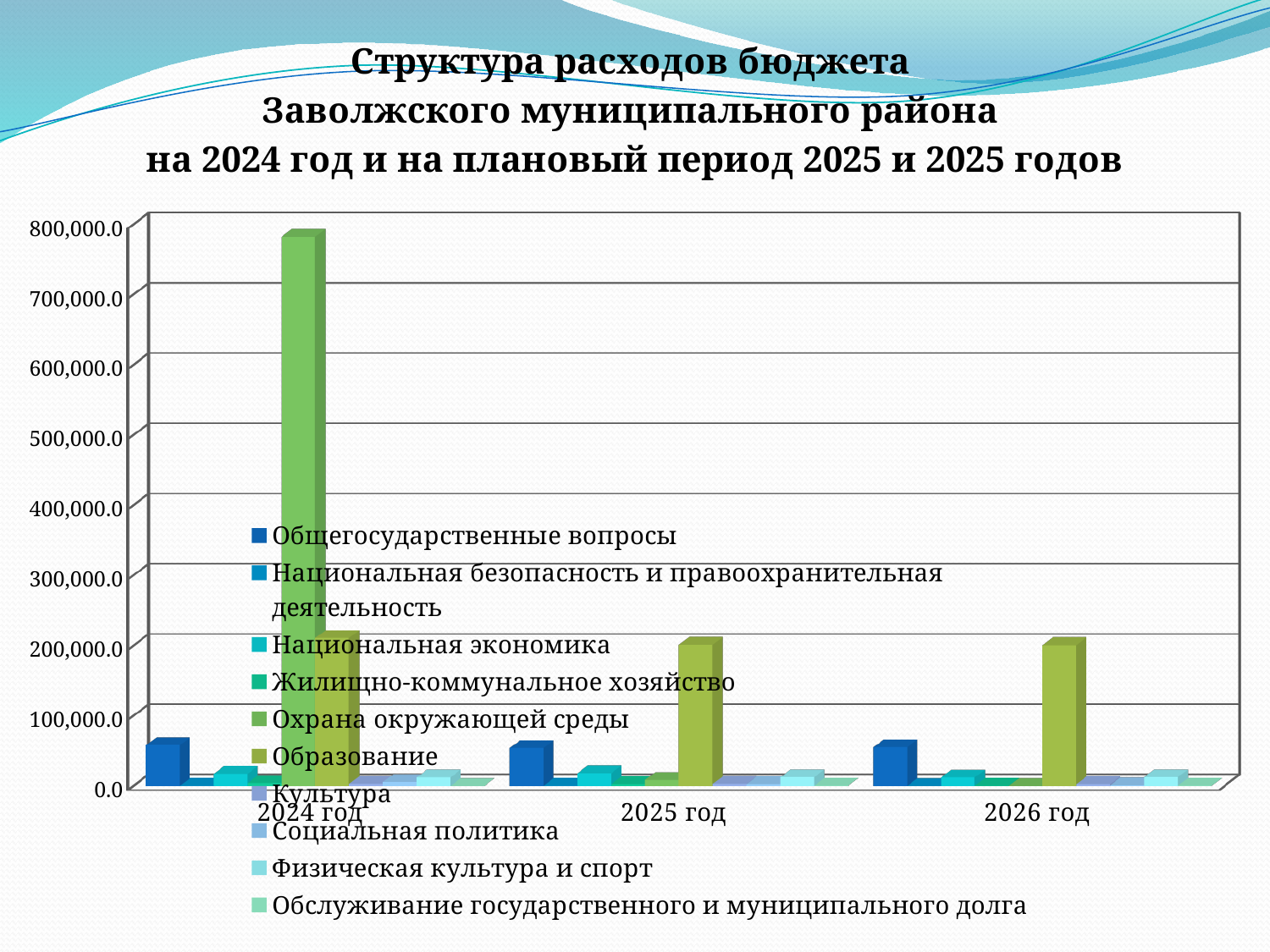
In 2024 год, which is larger: Охрана окружающей среды or Образование? Охрана окружающей среды Does the value for Охрана окружающей среды rise or fall from 2024 год to 2025 год? fall What is the first series listed in the legend? Общегосударственные вопросы Is the value for Образование in 2025 год greater or less than 100,000.0? greater Is the value for Охрана окружающей среды in 2024 год greater or less than 700,000.0? greater Is the value for Общегосударственные вопросы in 2024 год greater or less than 100,000.0? less What kind of chart is shown on the slide? bar chart How many series does the legend list? 10 How many year categories are shown on the x axis? 3 Which year category contains the tallest bar in the chart? 2024 год In 2025 год, which is larger: Образование or Общегосударственные вопросы? Образование